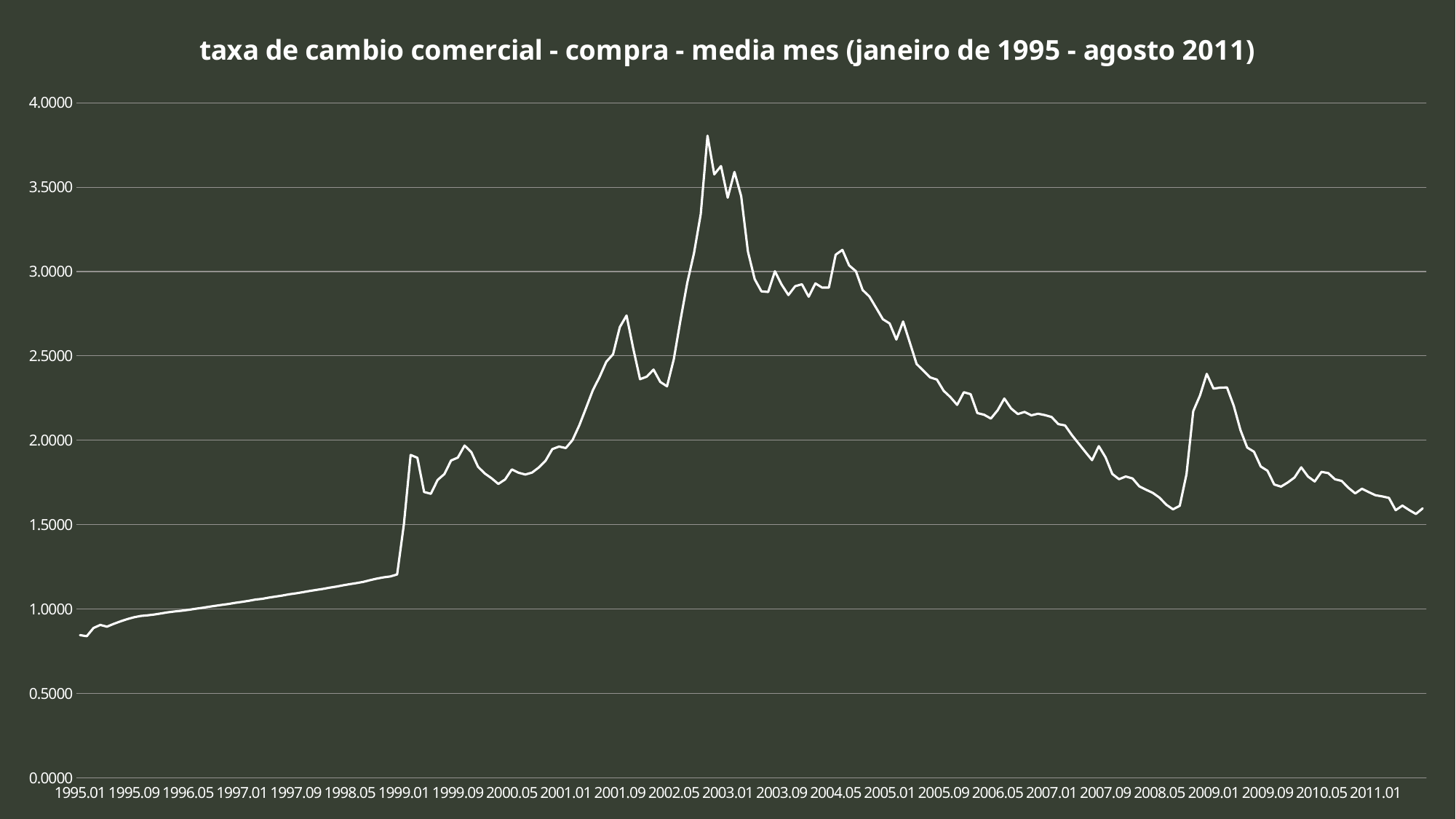
Is the value for 2009.01 greater or less than 2.0000? greater Is the value for 1995.01 greater or less than 1.0000? less Is the value for 2001.09 greater or less than 2.5000? greater How many lines are plotted on the chart? 1 Which has the larger value, 1995.01 or 2011.01? 2011.01 Between 2003.01 and 2008.05, does the line generally rise or fall? fall What is the title of the chart? taxa de cambio comercial - compra - media mes (janeiro de 1995 - agosto 2011) What kind of chart is shown on the slide? line chart Which has the larger value, 2001.09 or 2005.09? 2001.09